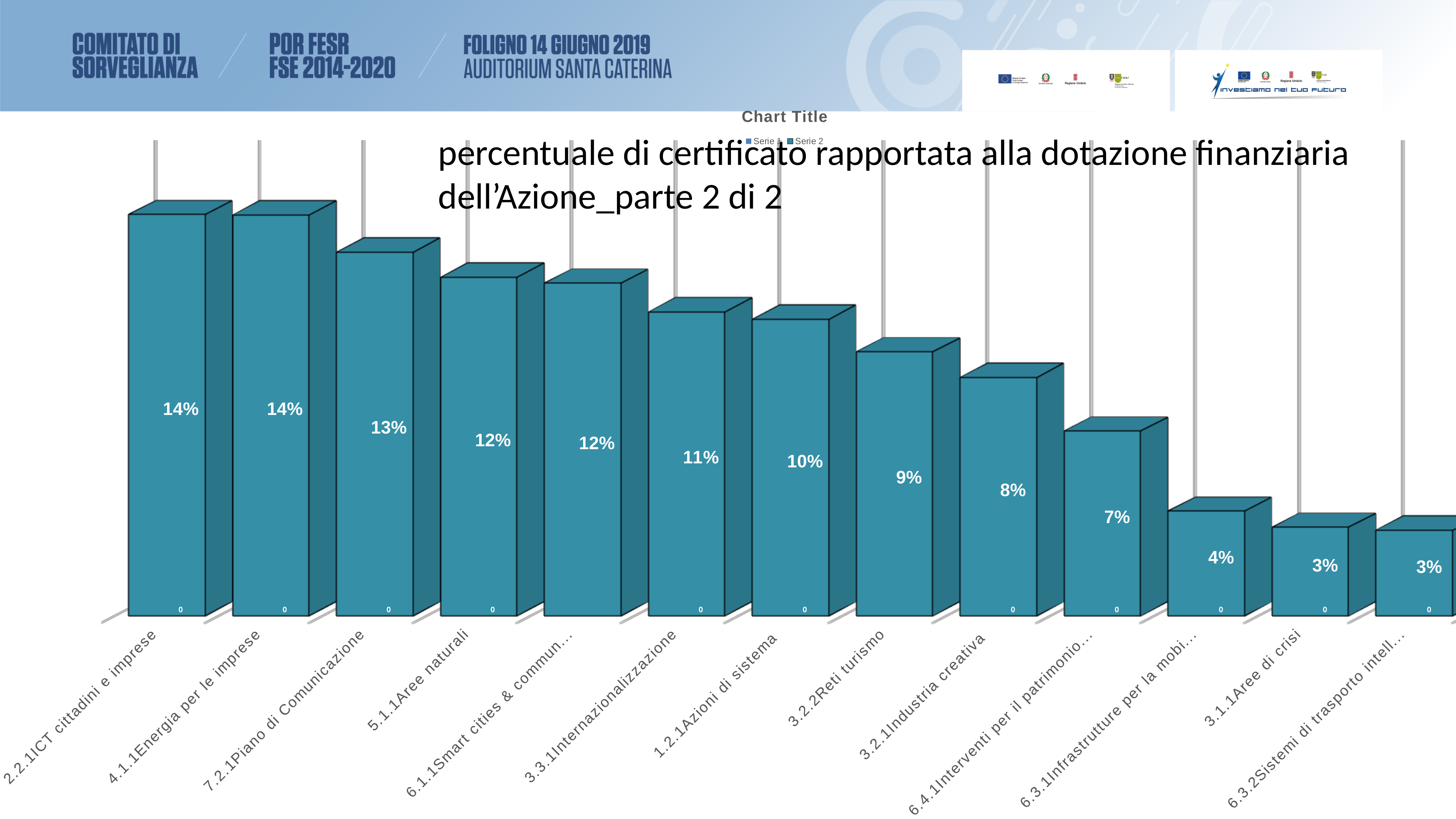
What is the value for 3.3.1Internazionalizzazione? 11% What kind of chart is shown on the slide? Bar chart Which is larger, the value for 5.1.1Aree naturali or the value for 3.2.2Reti turismo? 5.1.1Aree naturali What is the value for 3.2.2Reti turismo? 9% What is the value for 3.1.1Aree di crisi? 3% How many series does the legend list? 2 What is the value for 1.2.1Azioni di sistema? 10% How many bars are plotted in the chart? 13 Do the values rise or fall from left to right along the x axis? Fall What is the value for 3.2.1Industria creativa? 8% What is the value for 7.2.1Piano di Comunicazione? 13% What is the difference between the values for 2.2.1ICT cittadini e imprese and 3.2.1Industria creativa? 6%